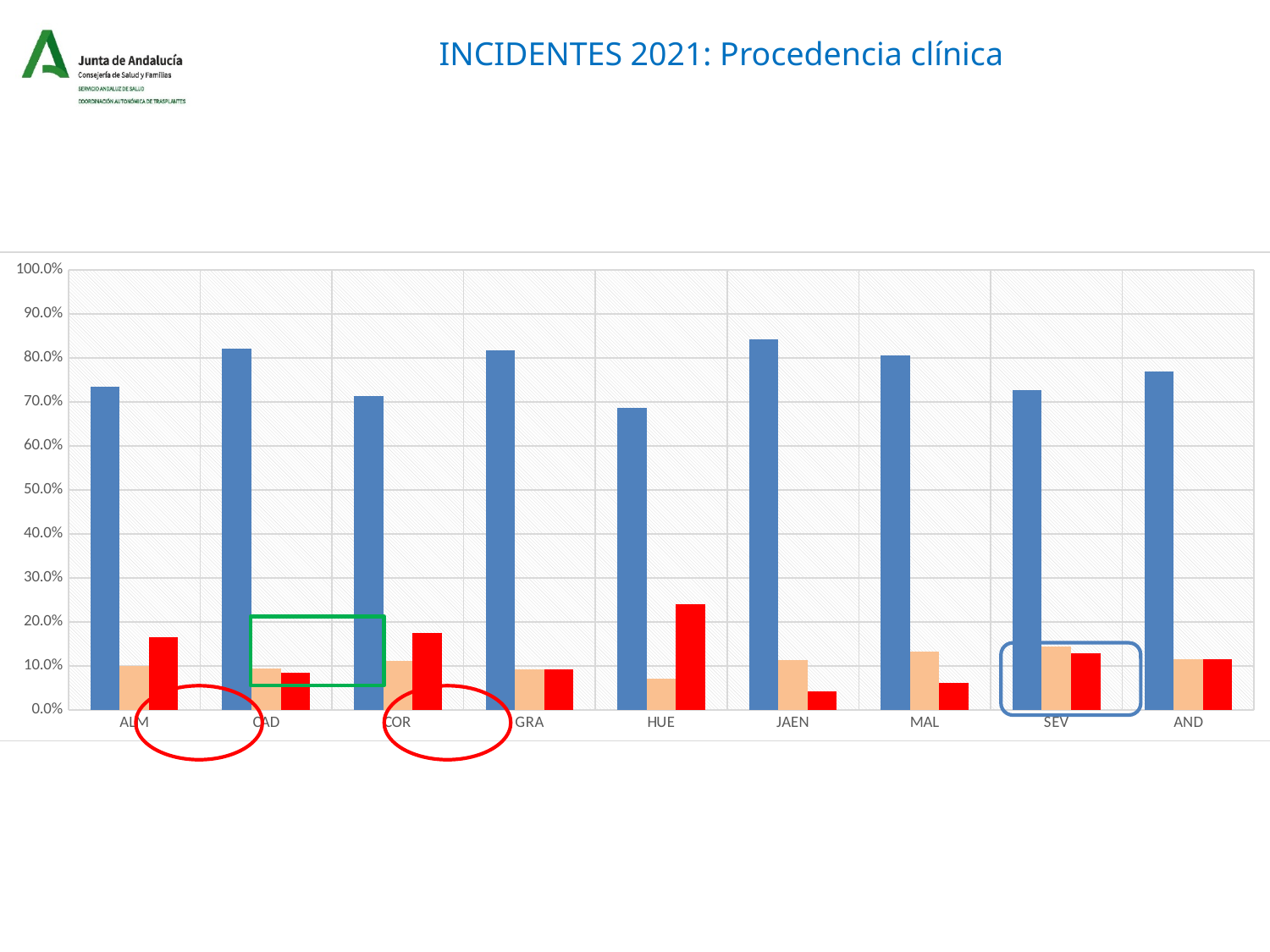
Is the value of the red bar for HUE greater or less than 20.0%? greater Which has the larger red bar, HUE or CAD? HUE Is the value of the red bar for JAEN greater or less than 10.0%? less Is the value of the blue bar for JAEN greater or less than 80.0%? greater Which category has the tallest red bar? HUE How many bars are plotted for each category in the chart? 3 What type of chart is shown on the slide? bar chart What is the title of the slide containing the chart? INCIDENTES 2021: Procedencia clínica Which category has the shortest red bar? JAEN How many categories are shown on the x axis of the chart? 9 Which has the larger blue bar, CAD or HUE? CAD